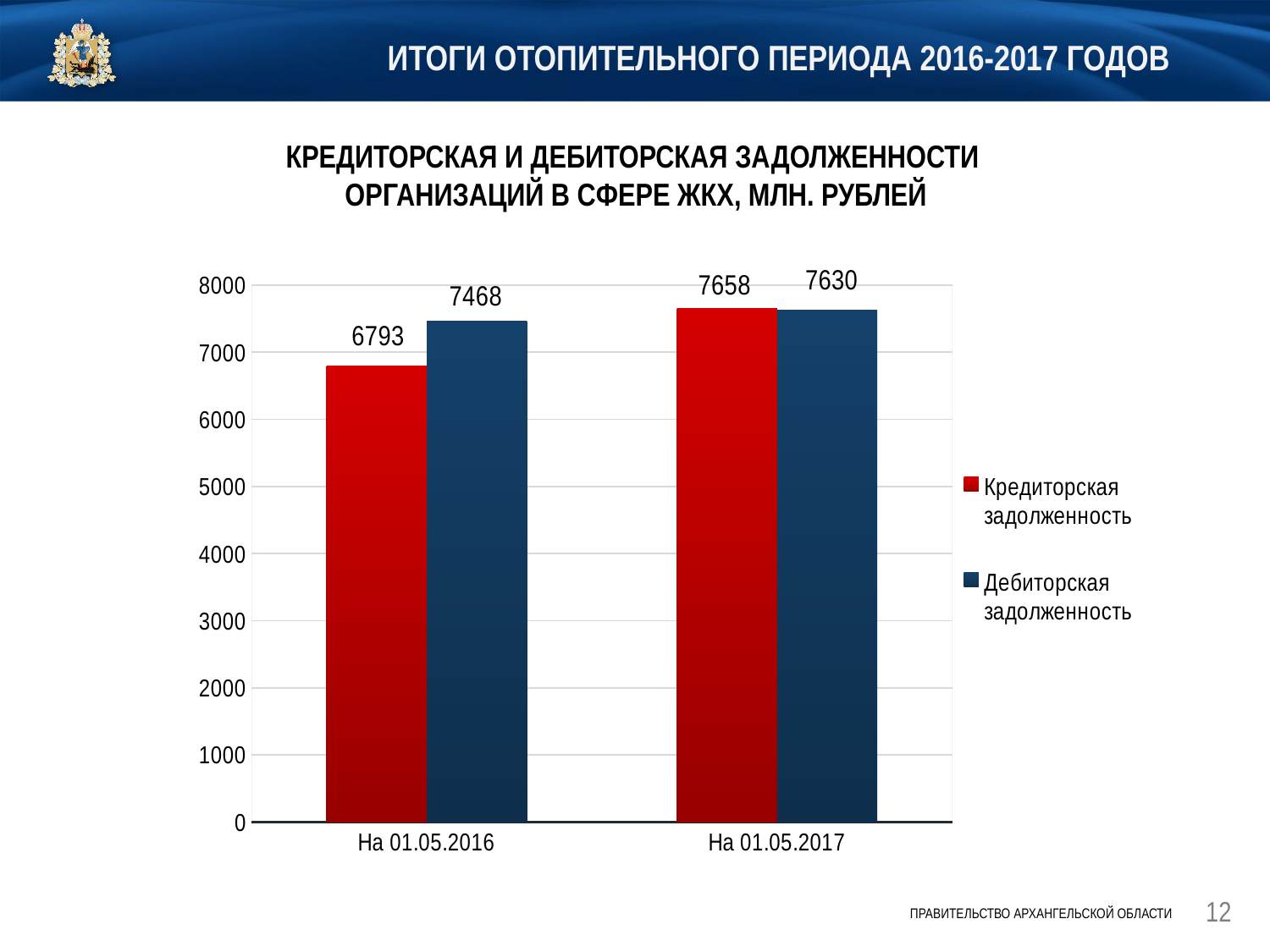
What is the value of Дебиторская задолженность for На 01.05.2017? 7630 How many categories are shown on the x axis? 2 Does Кредиторская задолженность rise or fall from На 01.05.2016 to На 01.05.2017? rise Which is larger for На 01.05.2016: Кредиторская задолженность or Дебиторская задолженность? Дебиторская задолженность Which category has the lowest value for Кредиторская задолженность? На 01.05.2016 What is the difference between Дебиторская задолженность and Кредиторская задолженность for На 01.05.2016? 675 What is the value of Дебиторская задолженность for На 01.05.2016? 7468 What is the value of Кредиторская задолженность for На 01.05.2017? 7658 What kind of chart is shown on the slide? bar chart What is the value of Кредиторская задолженность for На 01.05.2016? 6793 What is the difference between Кредиторская задолженность for На 01.05.2017 and На 01.05.2016? 865 How many series does the legend list? 2